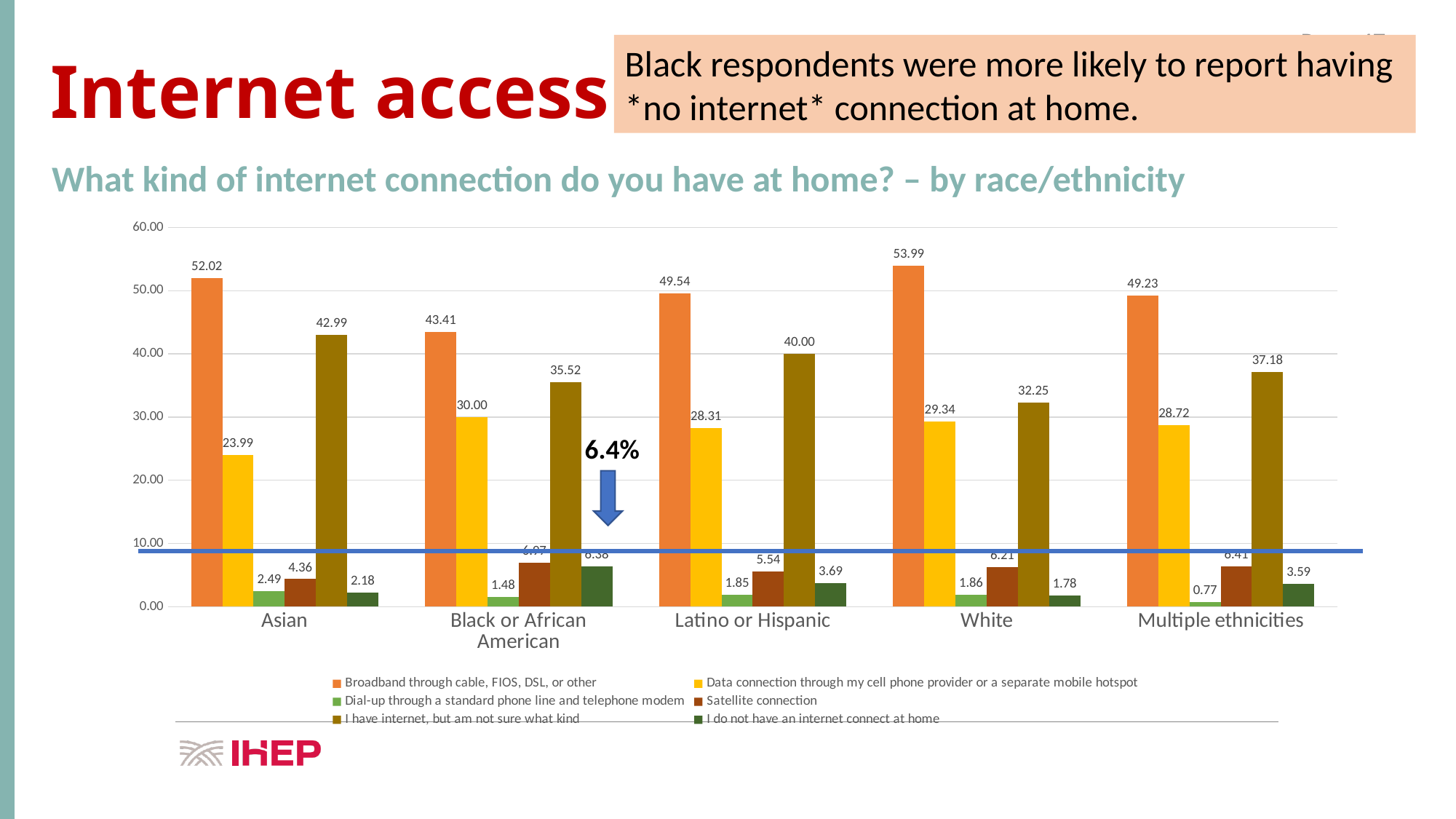
Which race/ethnicity group has the highest value for Broadband through cable, FIOS, DSL, or other? White What is the difference between the Broadband values for White and Asian respondents? 1.97 How many race/ethnicity categories are shown on the x axis? 5 What is the value for 'I have internet, but am not sure what kind' for Asian respondents? 42.99 Is the value for 'I do not have an internet connect at home' for Black or African American respondents greater or less than 10.00? less Is the 'I have internet, but am not sure what kind' value larger for Latino or Hispanic or for Multiple ethnicities? Latino or Hispanic What kind of chart is shown on the slide? Bar chart What is the value for Dial-up through a standard phone line and telephone modem for Multiple ethnicities? 0.77 Which race/ethnicity group has the lowest value for Broadband through cable, FIOS, DSL, or other? Black or African American What is the value for Broadband through cable, FIOS, DSL, or other for White respondents? 53.99 What is the value for Data connection through my cell phone provider or a separate mobile hotspot for Black or African American respondents? 30.00 How many series does the legend list? 6